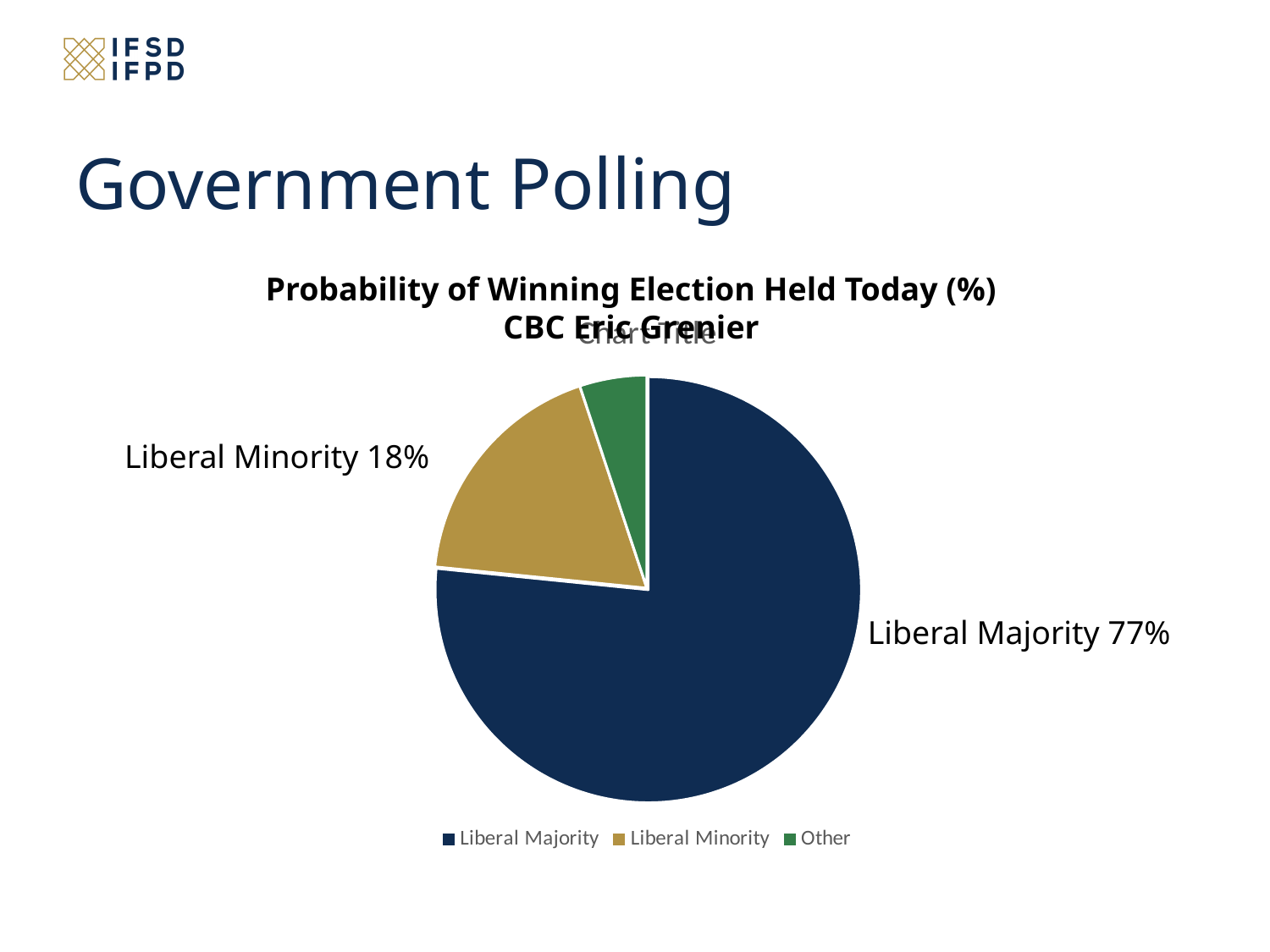
Which category has the largest slice of the pie chart? Liberal Majority What colour is the Liberal Minority slice in the pie chart? Gold What kind of chart is shown on the slide? Pie chart What is the value shown for Liberal Majority in the pie chart? 77% Which category has the smallest slice of the pie chart? Other How many categories are shown in the pie chart? 3 What is the value shown for Liberal Minority in the pie chart? 18% What are the three entries listed in the chart's legend? Liberal Majority, Liberal Minority, Other What share of the pie does the Liberal Majority slice represent? 77% What is the difference in percentage points between the Liberal Majority and Liberal Minority slices? 58 How many entries does the legend of the pie chart list? 3 Which is larger, the slice for Liberal Majority or the slice for Liberal Minority? Liberal Majority